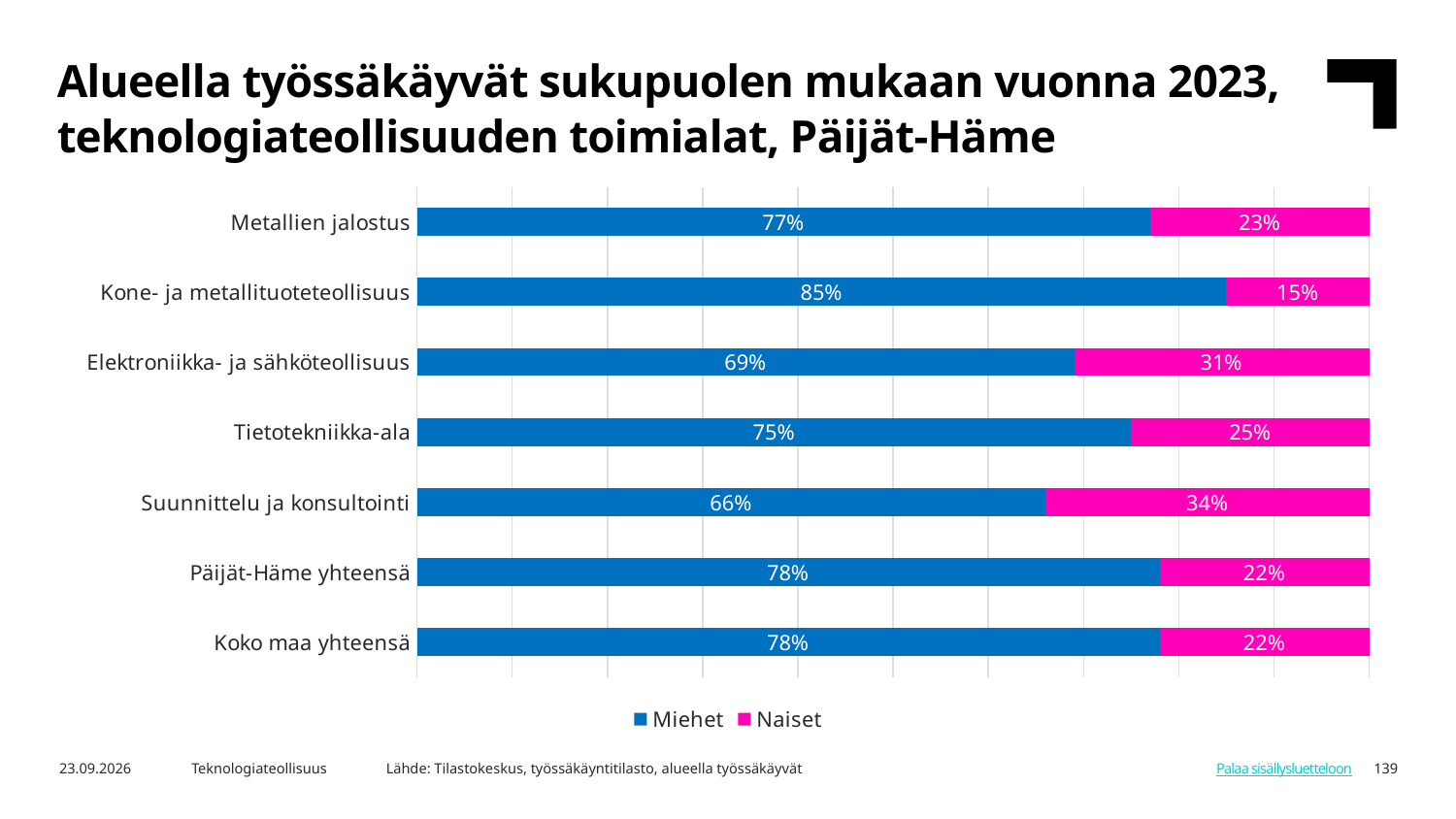
What is the Naiset share for Suunnittelu ja konsultointi? 34% What is the Naiset share for Kone- ja metallituoteteollisuus? 15% How many categories are shown on the chart? 7 Which is larger: the Naiset share for Metallien jalostus or for Tietotekniikka-ala? Tietotekniikka-ala What is the total of the stacked bar for Päijät-Häme yhteensä? 100% What kind of chart is shown on the slide? Stacked bar chart Which category has the lowest Miehet share? Suunnittelu ja konsultointi What is the difference between the Miehet and Naiset shares for Elektroniikka- ja sähköteollisuus? 38 percentage points How many series does the legend list? 2 What is the Miehet share for Tietotekniikka-ala? 75% Which category has the highest Miehet share? Kone- ja metallituoteteollisuus What is the Miehet share for Metallien jalostus? 77%